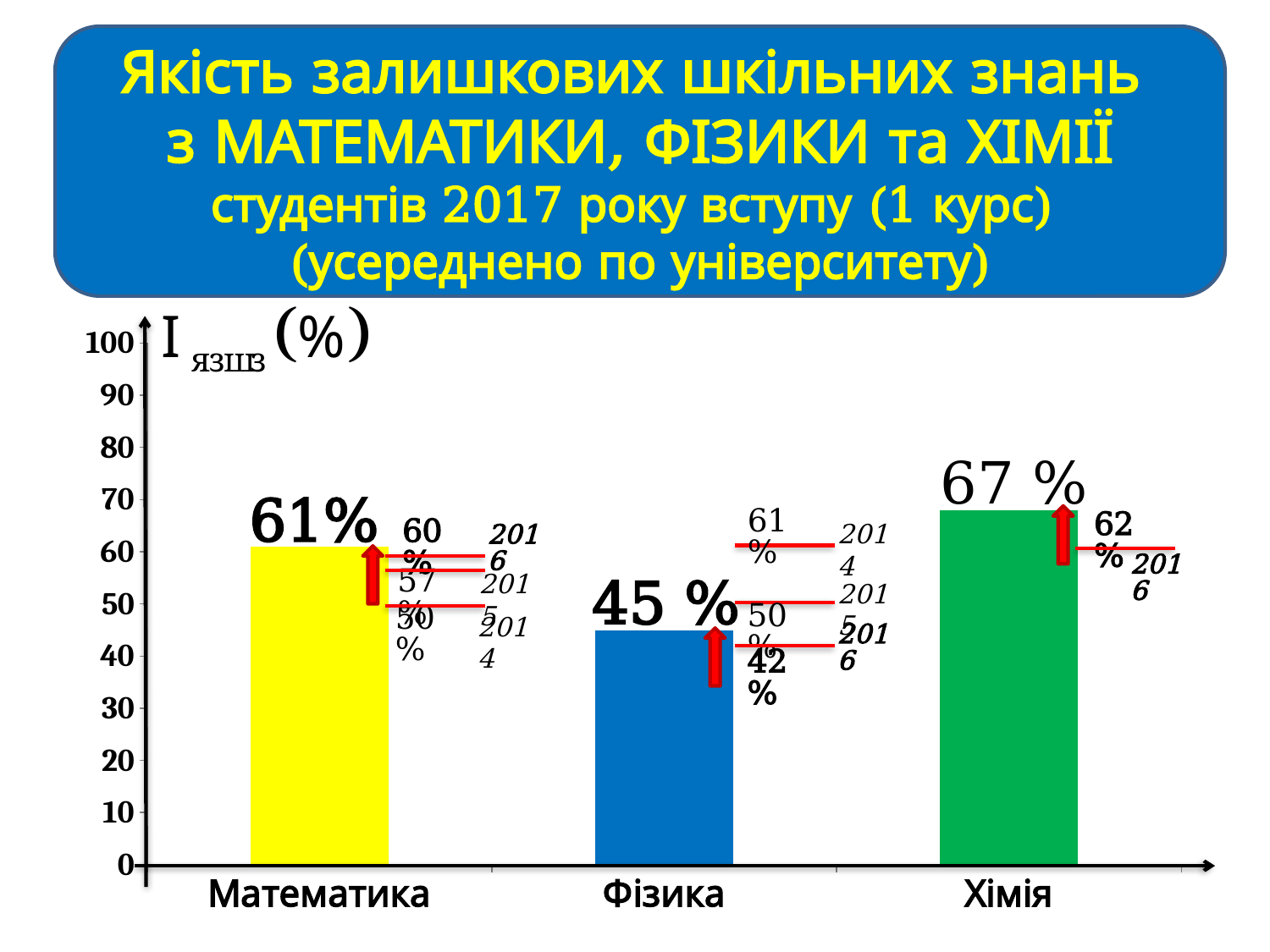
What kind of chart is shown on the slide? bar chart Which subject has the highest value? Хімія Which is larger, the value for Математика or the value for Фізика? Математика What is the value shown for Фізика? 45 % Which subject has the lowest value? Фізика What is the difference between the values for Математика and Фізика? 16 How many subjects are shown on the chart? 3 What colour is the bar for Хімія? green Is the value for Фізика greater or less than 50? less What is the difference between the values for Хімія and Математика? 6 What is the value shown for Хімія? 67 % What is the value shown for Математика? 61%